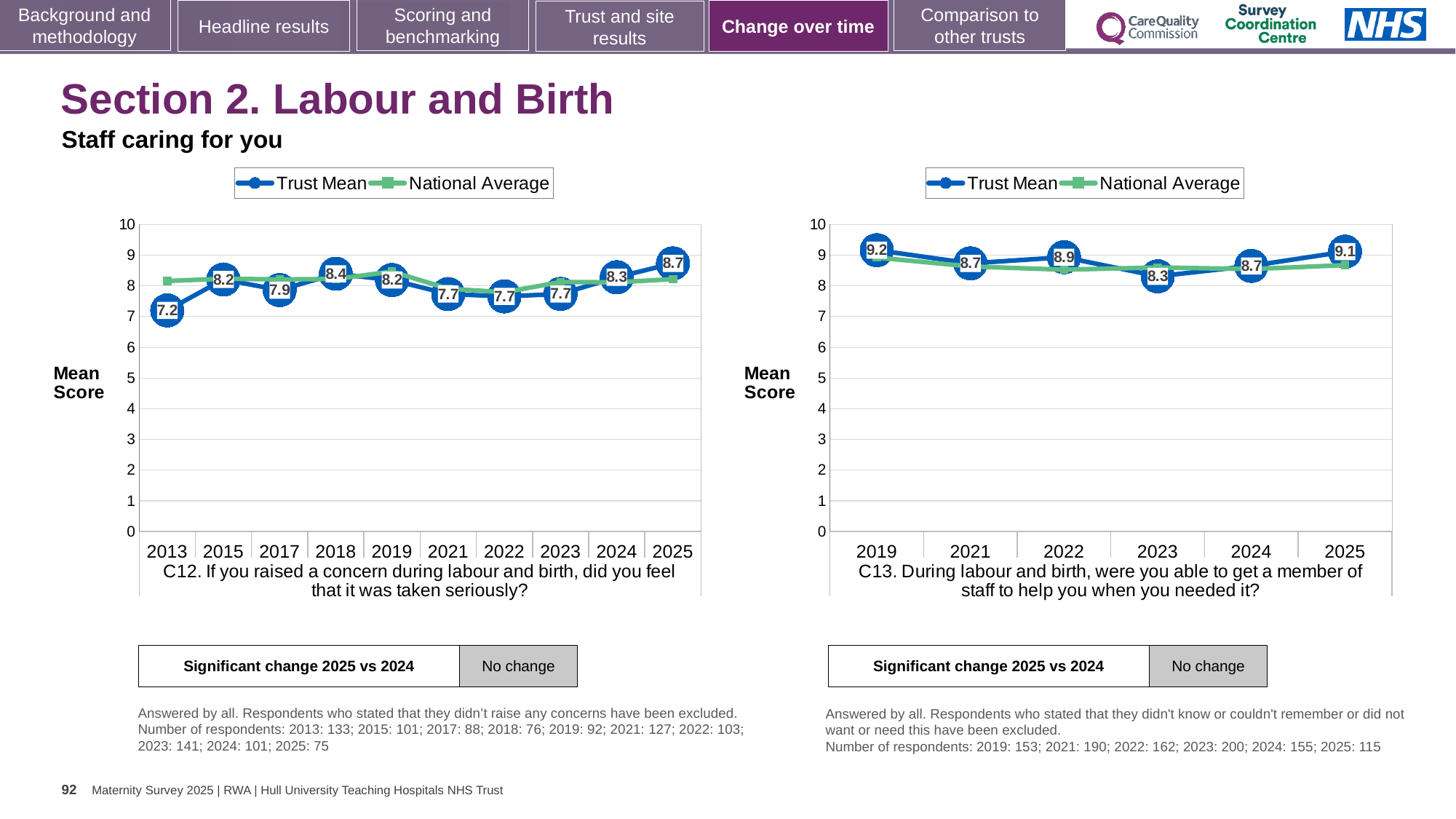
In the C13 chart (right), is the Trust Mean for 2019 greater or less than the Trust Mean for 2023? greater In the C12 chart (left), what is the difference between the Trust Mean for 2025 and the Trust Mean for 2024? 0.4 What kind of chart is the C12 chart (left)? Line chart In the C12 chart (left), which year has the highest Trust Mean? 2025 In the C12 chart (left), what is the Trust Mean for 2013? 7.2 How many series does the legend of the C13 chart (right) list? 2 In the C12 chart (left), what is the Trust Mean for 2025? 8.7 In the C13 chart (right), which year has the highest Trust Mean? 2019 In the C13 chart (right), is the National Average for 2025 greater or less than 8? greater How many years are plotted on the x axis of the C12 chart (left)? 10 In the C13 chart (right), what is the Trust Mean for 2023? 8.3 In the C12 chart (left), which year has the lowest Trust Mean? 2013